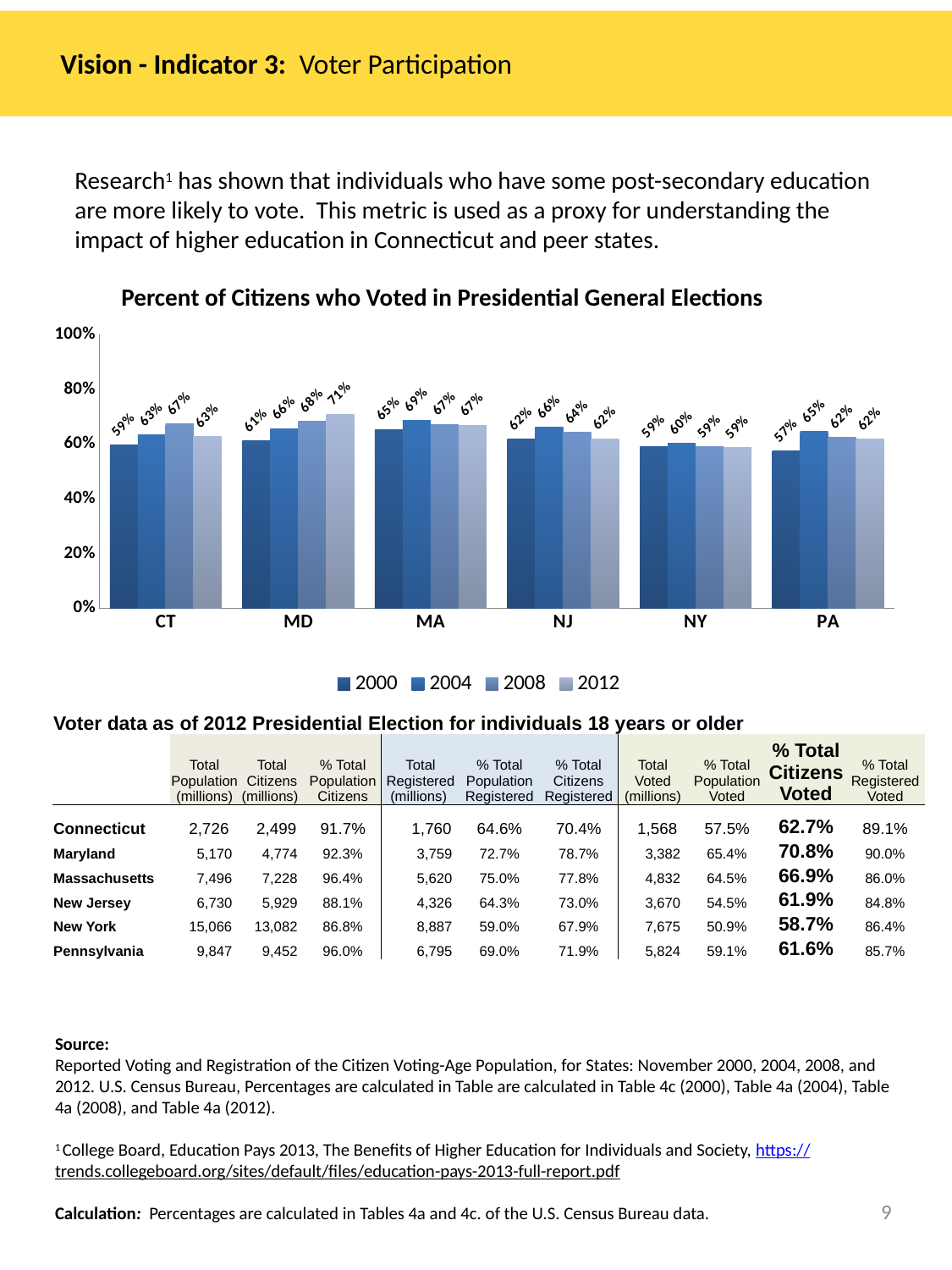
Which state has the highest value for 2012? MD What kind of chart is shown? bar chart What is the value for MA in 2004? 69% Which is larger, the 2004 value for PA or the 2004 value for NY? PA Do the values for MD rise or fall from 2000 to 2012? rise What is the value for CT in 2000? 59% How many series does the legend list? 4 What is the value for MD in 2012? 71% What is the difference between the 2012 values for MD and CT? 8 percentage points Which state has the lowest value for 2000? PA How many states are shown on the x axis? 6 Is the value for NY in 2008 greater or less than 80%? less